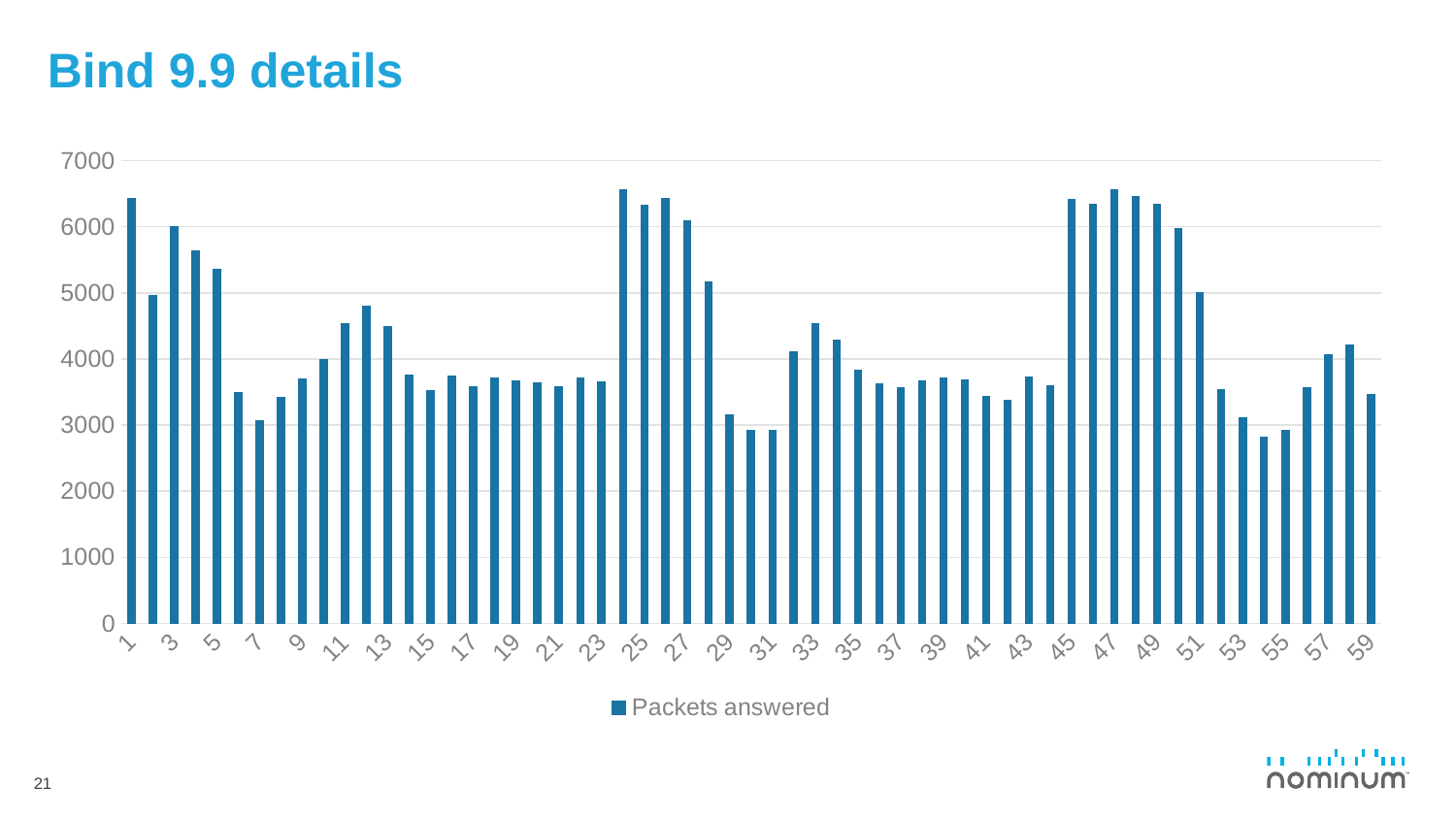
What is the title of the slide containing the chart? Bind 9.9 details Is the value for category 7 greater or less than 4000? less How many series does the legend list? 1 Which has the larger value, category 1 or category 7? category 1 What kind of chart is shown on the slide? bar chart Is the value for category 47 greater or less than 6000? greater How many bars are plotted in the chart? 59 Is the value for category 12 greater or less than 4000? greater Do the values rise or fall from category 1 to category 7? fall What is the name of the series shown in the legend? Packets answered